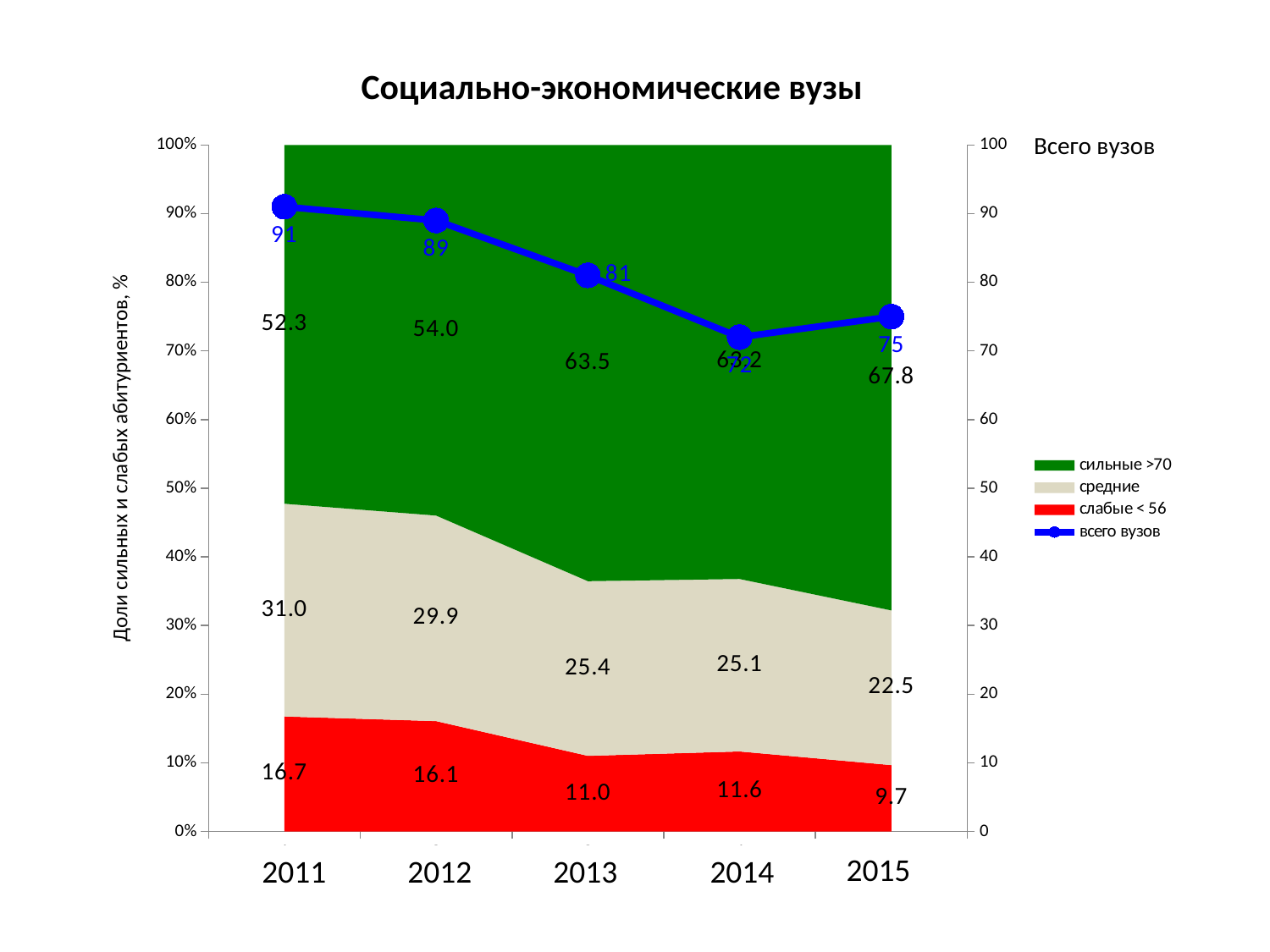
What is the value for слабые < 56 in 2015? 9.7 What is the value for средние in 2014? 25.1 In which year is the share of сильные >70 highest? 2015 In which year is всего вузов lowest? 2014 Which is larger: the share of средние in 2012 or in 2013? 2012 How many series does the legend list? 4 What is the value of всего вузов in 2013? 81 Does the share of слабые < 56 generally rise or fall from 2011 to 2015? fall What is the title of the chart? Социально-экономические вузы How many years are shown on the x axis? 5 What is the value for сильные >70 in 2011? 52.3 What is the difference between всего вузов in 2011 and in 2015? 16